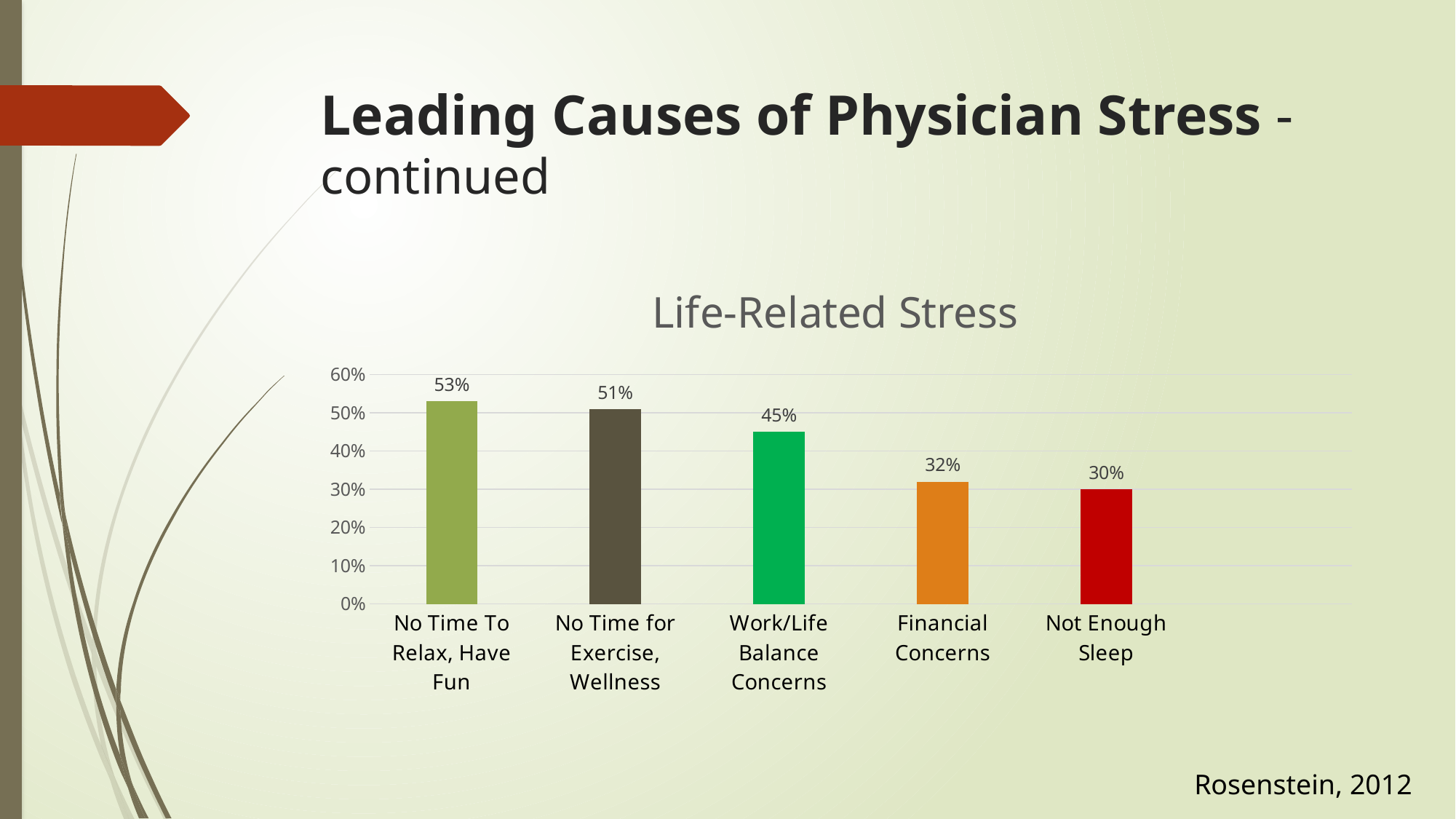
Which category has the highest value? No Time To Relax, Have Fun What is the value for Not Enough Sleep? 30% What is the difference between No Time for Exercise, Wellness and Financial Concerns? 19% What is the value for Financial Concerns? 32% How many categories are shown in the chart? 5 What is the value for Work/Life Balance Concerns? 45% Is the value for No Time for Exercise, Wellness greater or less than 40%? greater What is the title of the chart? Life-Related Stress Which category has the lowest value? Not Enough Sleep What kind of chart is shown on the slide? bar chart What is the value for No Time To Relax, Have Fun? 53% Which is larger, Work/Life Balance Concerns or Financial Concerns? Work/Life Balance Concerns